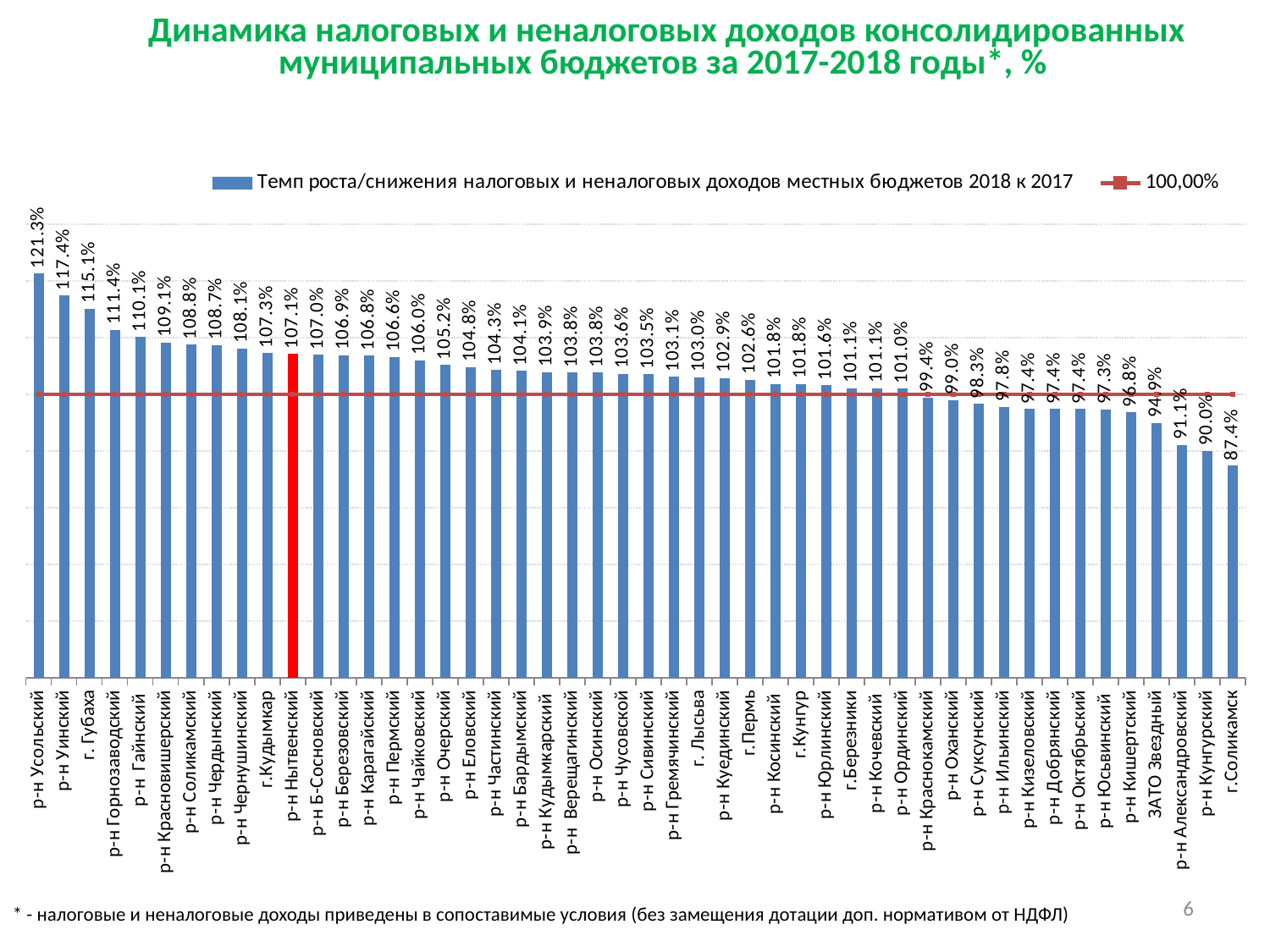
Do the bar values rise or fall from left to right along the x axis? fall Which category has the lowest value? г.Соликамск Which is larger, the value for г. Губаха or the value for г.Кудымкар? г. Губаха What is the difference between the values for р-н Усольский and г.Соликамск? 33.9% How many entries does the legend list? 2 Which category has the highest value? р-н Усольский What is the value for р-н Нытвенский, shown with the red bar? 107.1% What is the value for г.Пермь? 102.6% What is the value for г.Соликамск? 87.4% Is the value for р-н Краснокамский greater or less than 100%? less What kind of chart is shown on the slide? bar chart What is the value for р-н Усольский? 121.3%